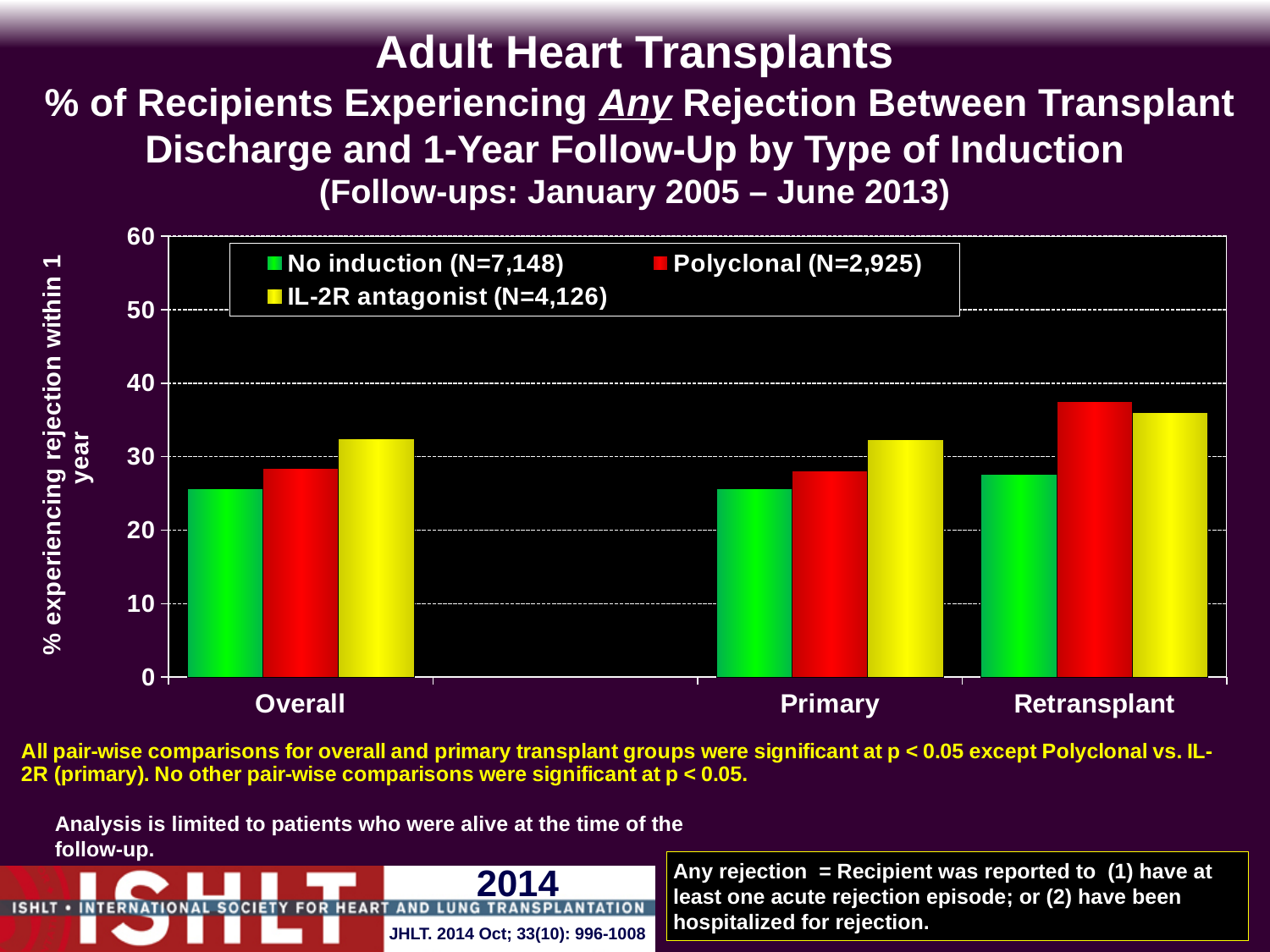
How many series does the legend list? 3 Is the value for Polyclonal in the Retransplant group greater or less than 30? greater Which is larger: the Polyclonal value in the Retransplant group or the Polyclonal value in the Primary group? Retransplant What is the sample size (N) shown in the legend for the No induction series? N=7,148 Which induction type has the highest percentage experiencing rejection in the Overall group? IL-2R antagonist How many transplant groups (categories) are shown on the x axis? 3 In the Primary group, which is larger: the value for Polyclonal or the value for No induction? Polyclonal Is the value for No induction in the Primary group greater or less than 30? less Which induction type has the lowest percentage experiencing rejection in the Retransplant group? No induction Which induction type has the lowest percentage experiencing rejection in the Overall group? No induction Is the value for IL-2R antagonist in the Overall group greater or less than 30? greater What kind of chart is shown on the slide? bar chart